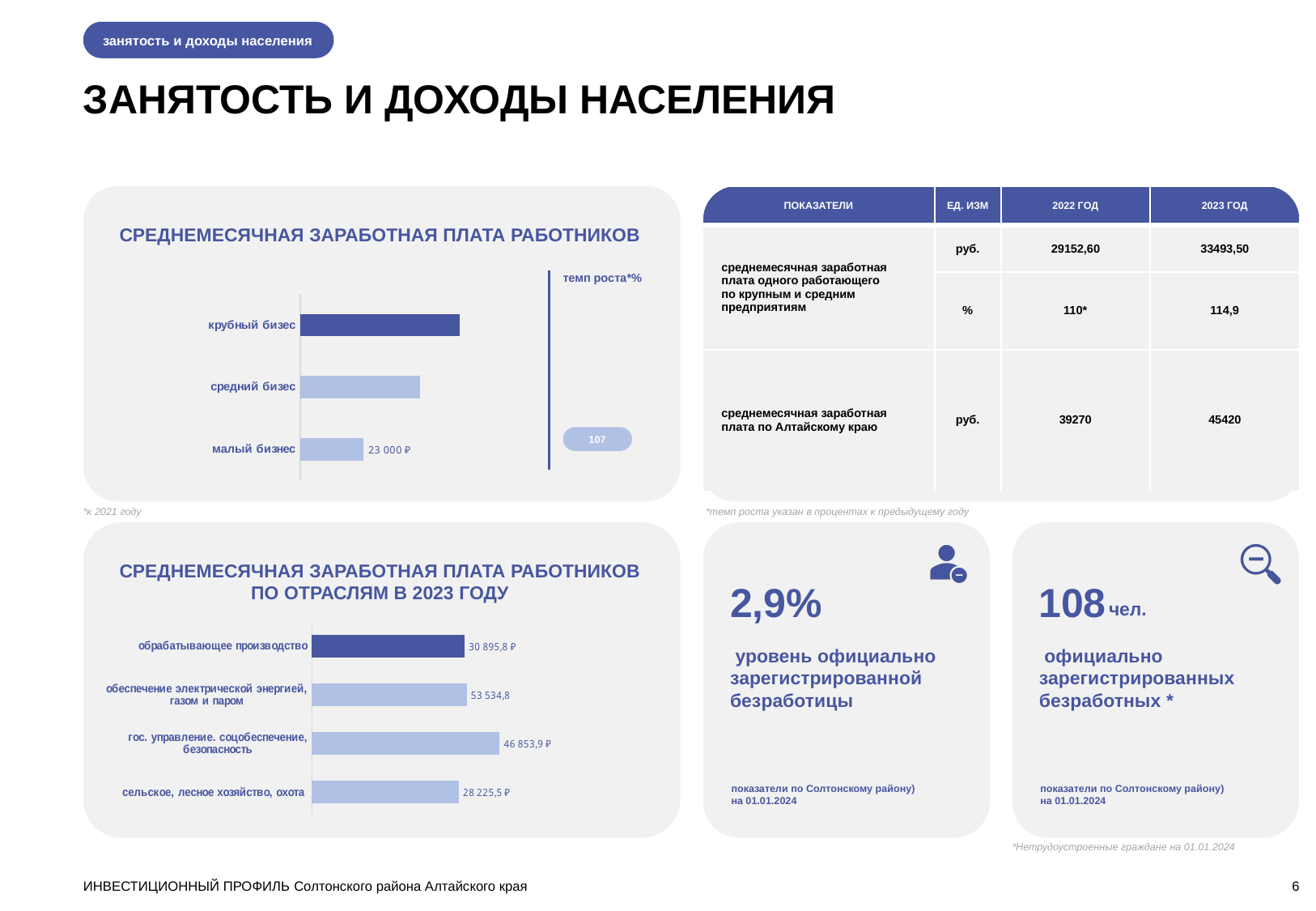
What type of chart is 'СРЕДНЕМЕСЯЧНАЯ ЗАРАБОТНАЯ ПЛАТА РАБОТНИКОВ ПО ОТРАСЛЯМ В 2023 ГОДУ' (bottom left)? bar chart In the chart 'СРЕДНЕМЕСЯЧНАЯ ЗАРАБОТНАЯ ПЛАТА РАБОТНИКОВ ПО ОТРАСЛЯМ В 2023 ГОДУ' (bottom left), what is the value for обеспечение электрической энергией, газом и паром? 53 534,8 In the chart 'СРЕДНЕМЕСЯЧНАЯ ЗАРАБОТНАЯ ПЛАТА РАБОТНИКОВ ПО ОТРАСЛЯМ В 2023 ГОДУ' (bottom left), what is the value for гос. управление. соцобеспечение, безопасность? 46 853,9 ₽ In the chart 'СРЕДНЕМЕСЯЧНАЯ ЗАРАБОТНАЯ ПЛАТА РАБОТНИКОВ' (top left), which category has the longest bar? крубный бизес In the chart 'СРЕДНЕМЕСЯЧНАЯ ЗАРАБОТНАЯ ПЛАТА РАБОТНИКОВ ПО ОТРАСЛЯМ В 2023 ГОДУ' (bottom left), what is the value for сельское, лесное хозяйство, охота? 28 225,5 ₽ In the chart 'СРЕДНЕМЕСЯЧНАЯ ЗАРАБОТНАЯ ПЛАТА РАБОТНИКОВ' (top left), what is the value for малый бизнес? 23 000 ₽ In the chart 'СРЕДНЕМЕСЯЧНАЯ ЗАРАБОТНАЯ ПЛАТА РАБОТНИКОВ' (top left), what темп роста value is shown for малый бизнес? 107 In the chart 'СРЕДНЕМЕСЯЧНАЯ ЗАРАБОТНАЯ ПЛАТА РАБОТНИКОВ' (top left), which category has the shortest bar? малый бизнес In the chart 'СРЕДНЕМЕСЯЧНАЯ ЗАРАБОТНАЯ ПЛАТА РАБОТНИКОВ' (top left), how many categories are shown? 3 In the chart 'СРЕДНЕМЕСЯЧНАЯ ЗАРАБОТНАЯ ПЛАТА РАБОТНИКОВ ПО ОТРАСЛЯМ В 2023 ГОДУ' (bottom left), how many industries are shown? 4 In the chart 'СРЕДНЕМЕСЯЧНАЯ ЗАРАБОТНАЯ ПЛАТА РАБОТНИКОВ ПО ОТРАСЛЯМ В 2023 ГОДУ' (bottom left), what is the value for обрабатывающее производство? 30 895,8 ₽ In the chart 'СРЕДНЕМЕСЯЧНАЯ ЗАРАБОТНАЯ ПЛАТА РАБОТНИКОВ ПО ОТРАСЛЯМ В 2023 ГОДУ' (bottom left), what is the difference between the labelled values for обрабатывающее производство and сельское, лесное хозяйство, охота? 2 670,3 ₽